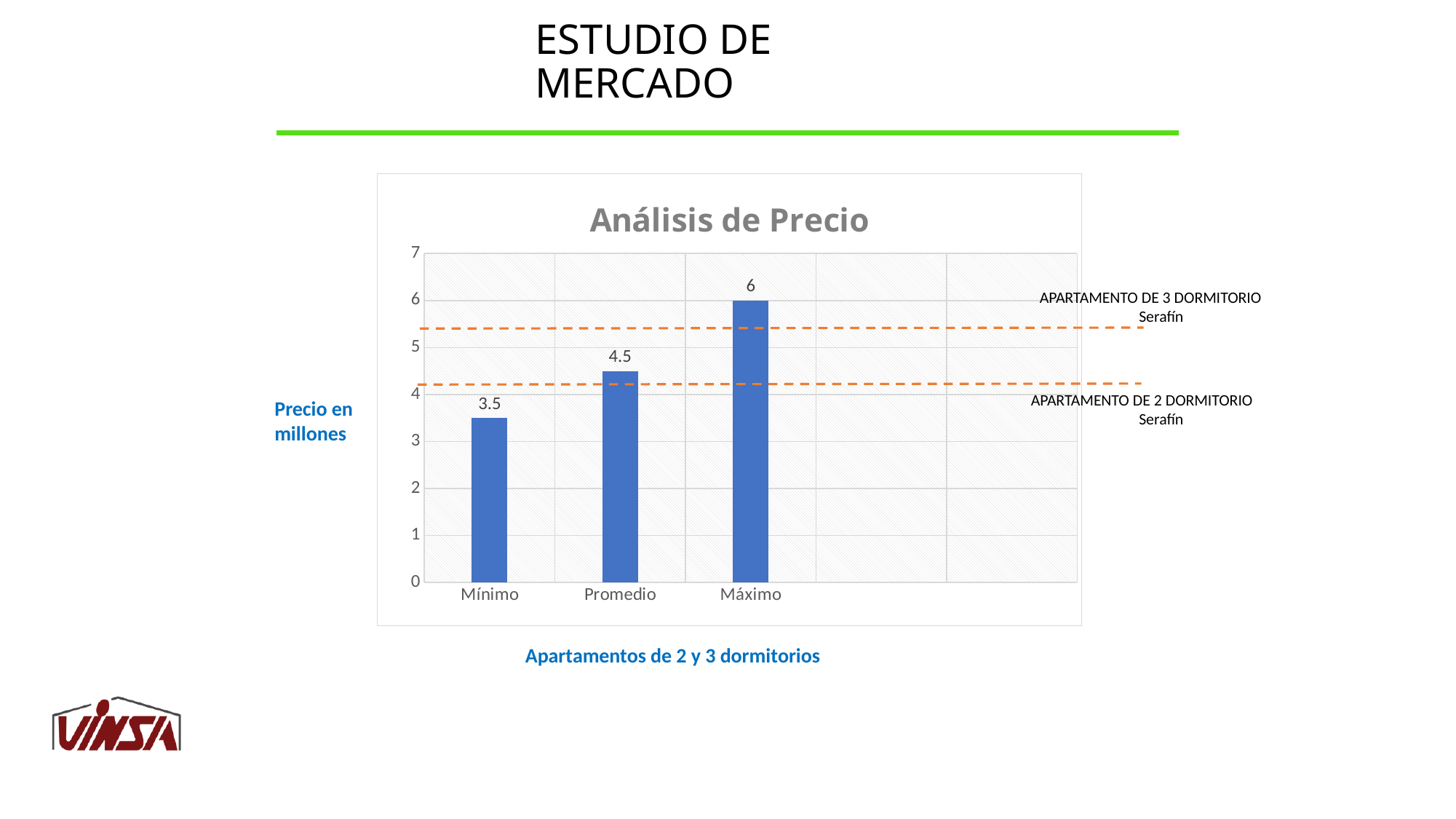
Is the value for Mínimo greater or less than 4? less What kind of chart is shown? bar chart Which category has the lowest value? Mínimo What is the difference between the values for Promedio and Mínimo? 1 What is the title of the chart? Análisis de Precio What is the value for Mínimo? 3.5 Which category has the highest value? Máximo How many categories are shown on the x axis? 3 What is the value for Promedio? 4.5 What is the value for Máximo? 6 Which is larger, the value for Promedio or the value for Máximo? Máximo What is the difference between the values for Máximo and Mínimo? 2.5